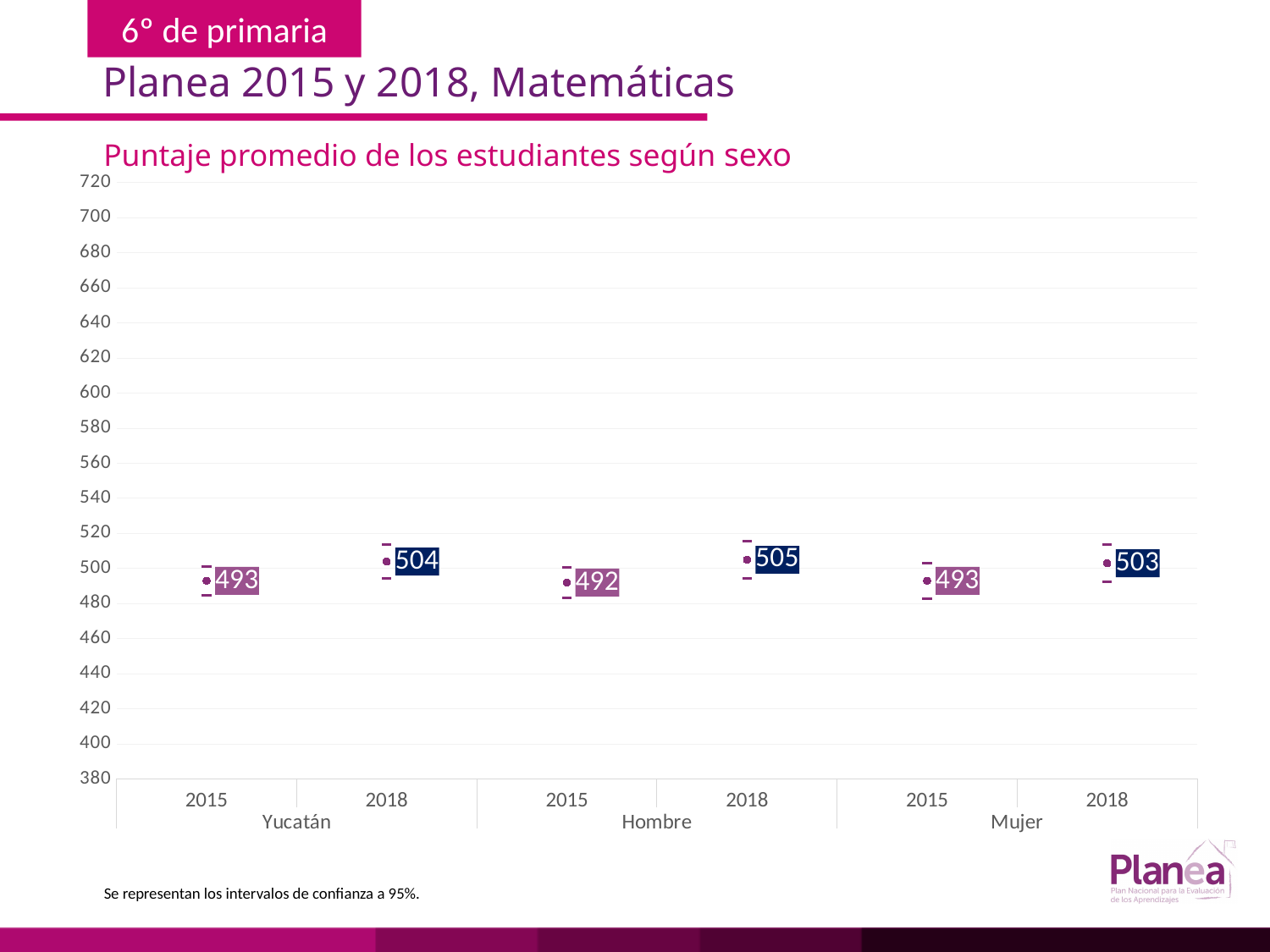
What is the average score for Yucatán in 2018? 504 What is the average score for Mujer in 2018? 503 What is the average score for Yucatán in 2015? 493 What is the difference between the Mujer scores in 2018 and 2015? 10 Which group and year has the highest average score? Hombre 2018 By how many points did the average score for Hombre increase from 2015 to 2018? 13 Which group and year has the lowest average score? Hombre 2015 What is the title of the chart? Puntaje promedio de los estudiantes según sexo How many data points are plotted on the chart? 6 What is the average score for Hombre in 2015? 492 Which is larger, the 2018 score for Hombre or the 2018 score for Mujer? Hombre What is the average score for Hombre in 2018? 505